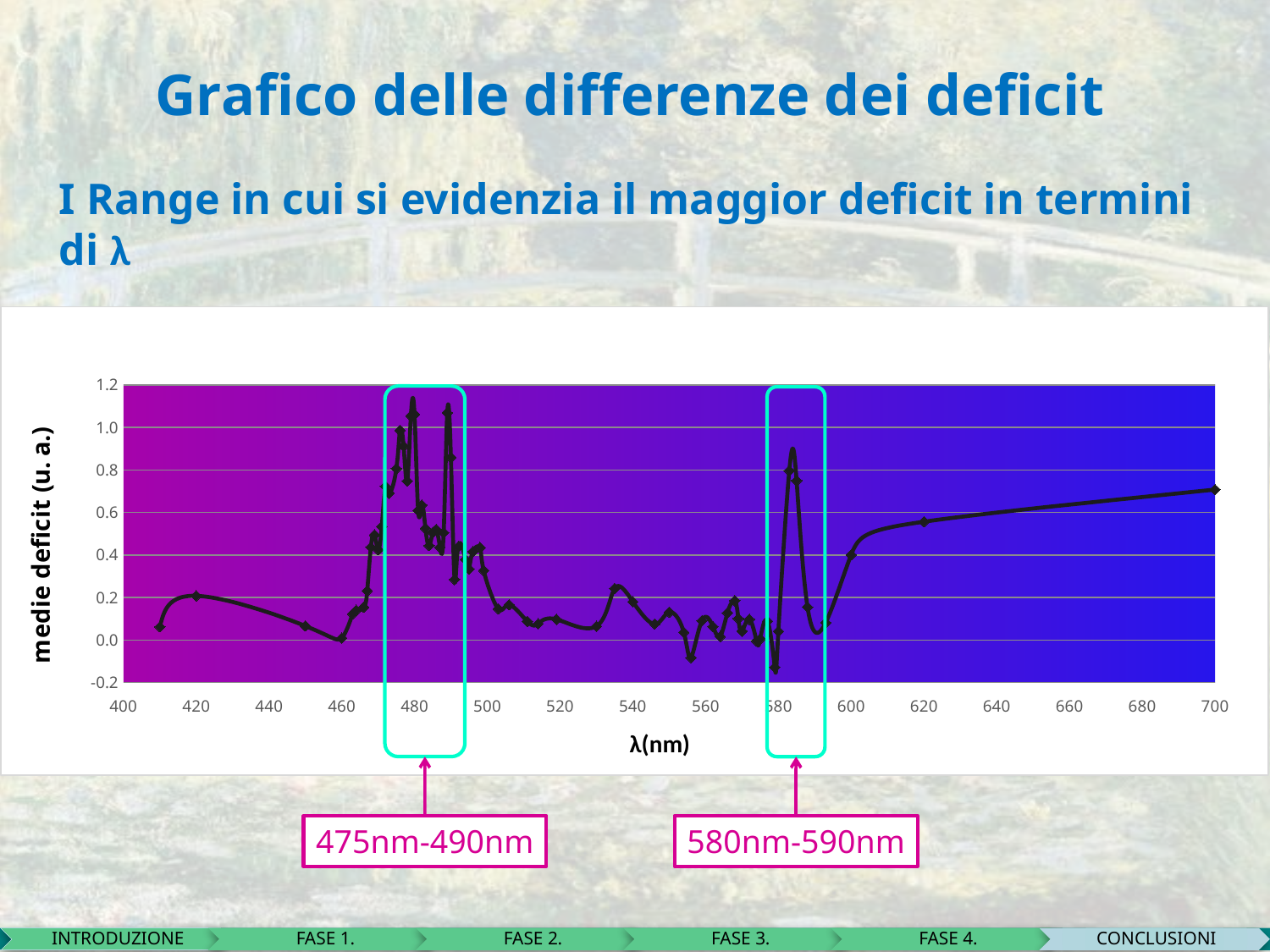
Is the value of medie deficit at 700 nm greater or less than 0.6? greater Between 420 nm and 460 nm, does the medie deficit rise or fall? fall Is the value of medie deficit at 460 nm greater or less than 0.2? less Which two wavelength ranges are highlighted on the chart as showing the greatest deficit? 475nm-490nm and 580nm-590nm Is the value of medie deficit at 620 nm greater or less than 0.4? greater Between 620 nm and 700 nm, does the medie deficit rise or fall? rise Which has the larger medie deficit value: 700 nm or 410 nm? 700 nm What is the label of the y axis of the chart? medie deficit (u. a.) Which has the larger medie deficit value: 620 nm or 460 nm? 620 nm What kind of chart is shown on the slide? line chart